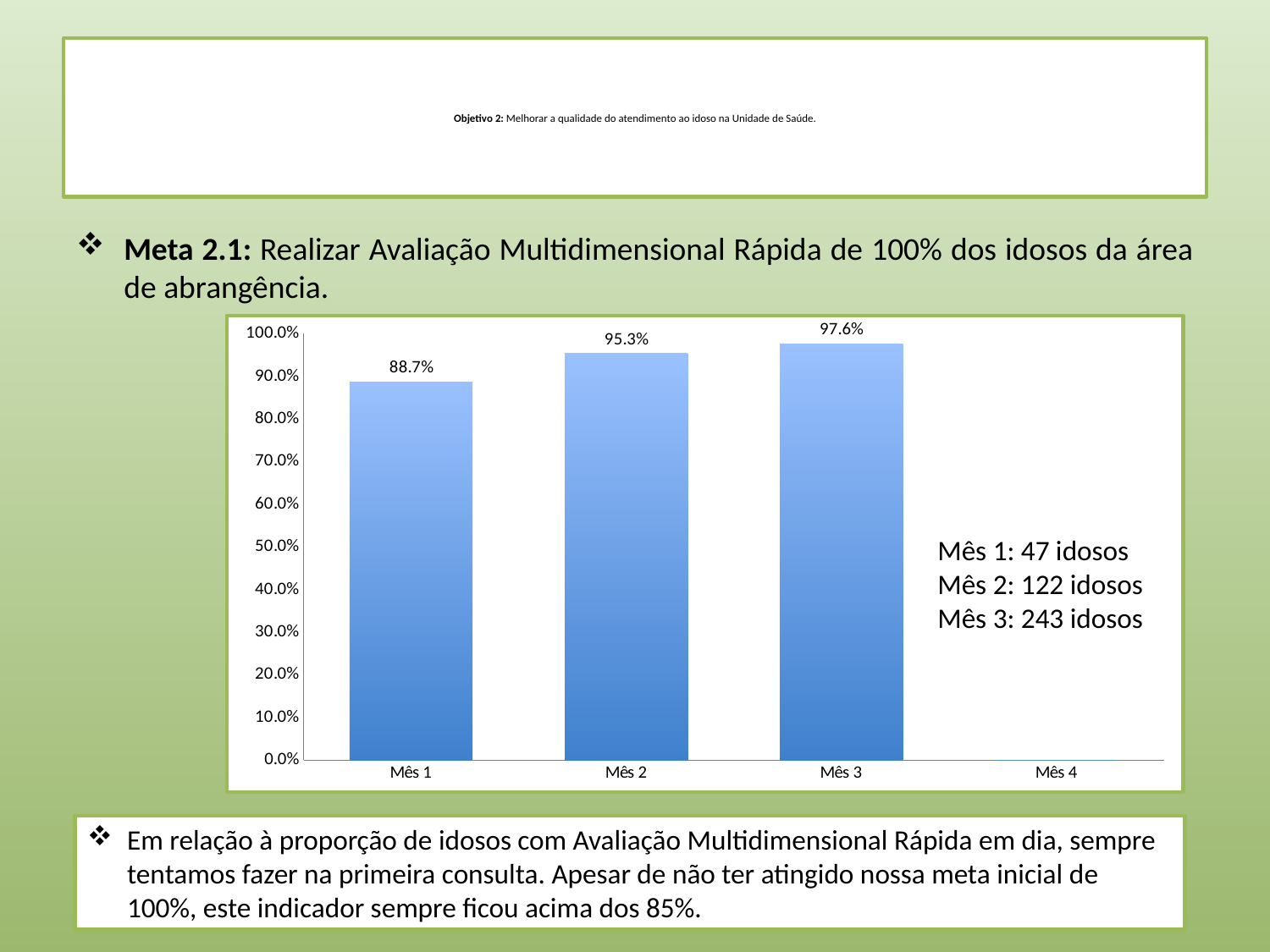
What is the value shown for Mês 1? 88.7% What is the value shown for Mês 3? 97.6% What is the value shown for Mês 2? 95.3% What is the difference between the values for Mês 2 and Mês 1? 6.6 percentage points What kind of chart is shown on the slide? bar chart How many categories are labelled on the x axis of the chart? 4 Which is larger, the value for Mês 2 or the value for Mês 3? Mês 3 What is the difference between the values for Mês 3 and Mês 1? 8.9 percentage points Do the bar values rise or fall from Mês 1 to Mês 3? rise Which month has the highest bar in the chart? Mês 3 Is the value for Mês 1 greater or less than 90.0%? less Among the three months that have a bar, which has the lowest value? Mês 1